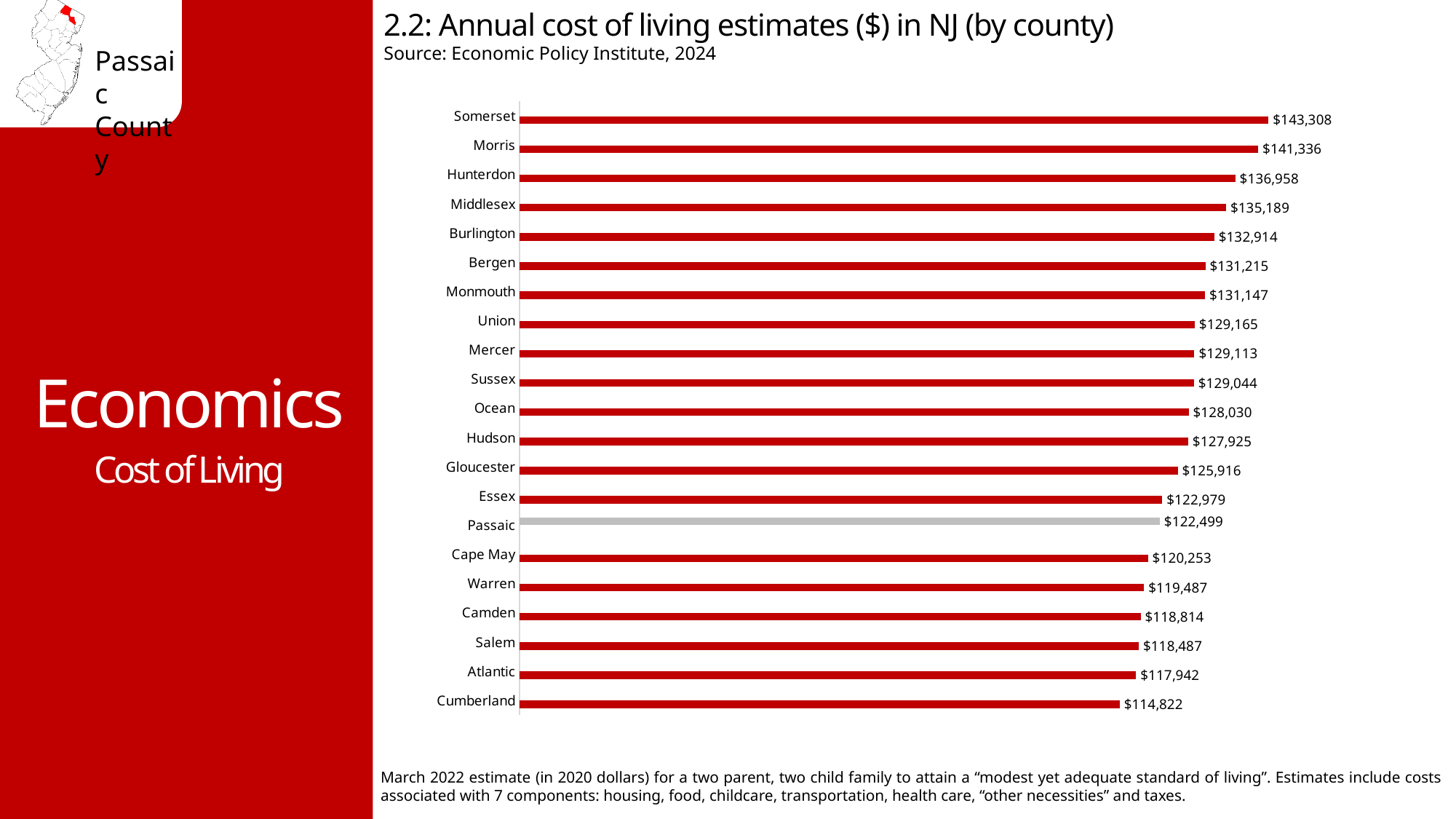
What is the difference between the cost of living estimates for Passaic and Cumberland? $7,677 Which county's bar is shown in gray instead of red? Passaic What kind of chart is used to show the annual cost of living estimates? Bar chart What is the annual cost of living estimate for Cape May County? $120,253 What is the difference between the cost of living estimates for Somerset and Cumberland? $28,486 Which county has a higher cost of living estimate, Morris or Hunterdon? Morris What is the annual cost of living estimate for Passaic County? $122,499 How many counties are shown in the chart? 21 Which county has the highest annual cost of living estimate? Somerset Which county has the lowest annual cost of living estimate? Cumberland Which county has a higher cost of living estimate, Hudson or Gloucester? Hudson What is the annual cost of living estimate for Bergen County? $131,215